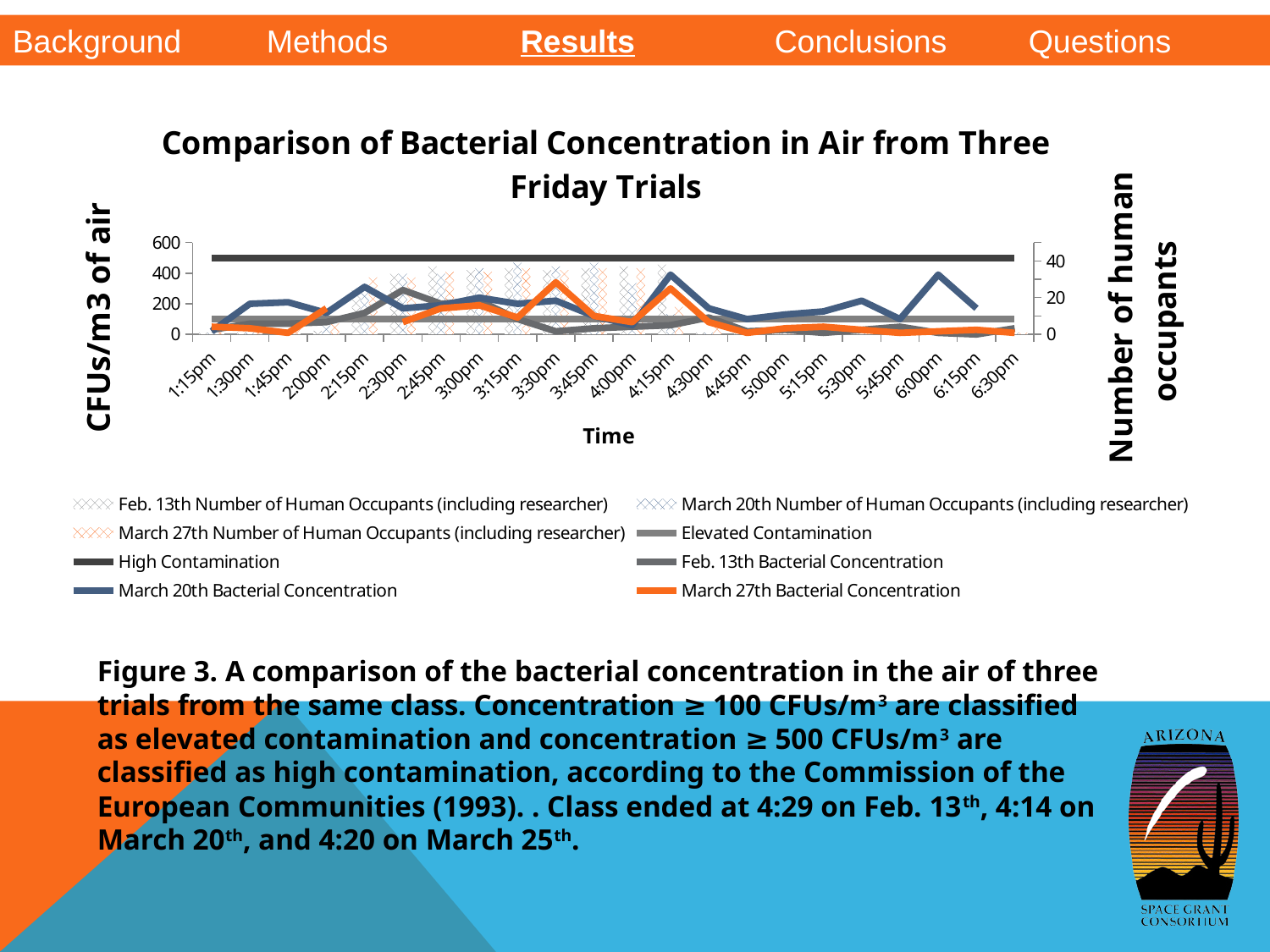
Is the value of the High Contamination line greater or less than 400 CFUs/m3? greater Is the March 20th Bacterial Concentration at 6:00pm greater or less than 200 CFUs/m3? greater What is the title of the x axis? Time What is the title of the chart? Comparison of Bacterial Concentration in Air from Three Friday Trials How many time points are shown along the x axis? 22 How many series does the chart legend list? 8 Does the March 20th Bacterial Concentration rise or fall from 6:00pm to 6:15pm? fall Is the value of the Elevated Contamination line greater or less than 200 CFUs/m3? less At 6:00pm, which is larger: the March 20th Bacterial Concentration or the March 27th Bacterial Concentration? March 20th Bacterial Concentration What kind of chart is shown on the slide? Combination line and bar chart